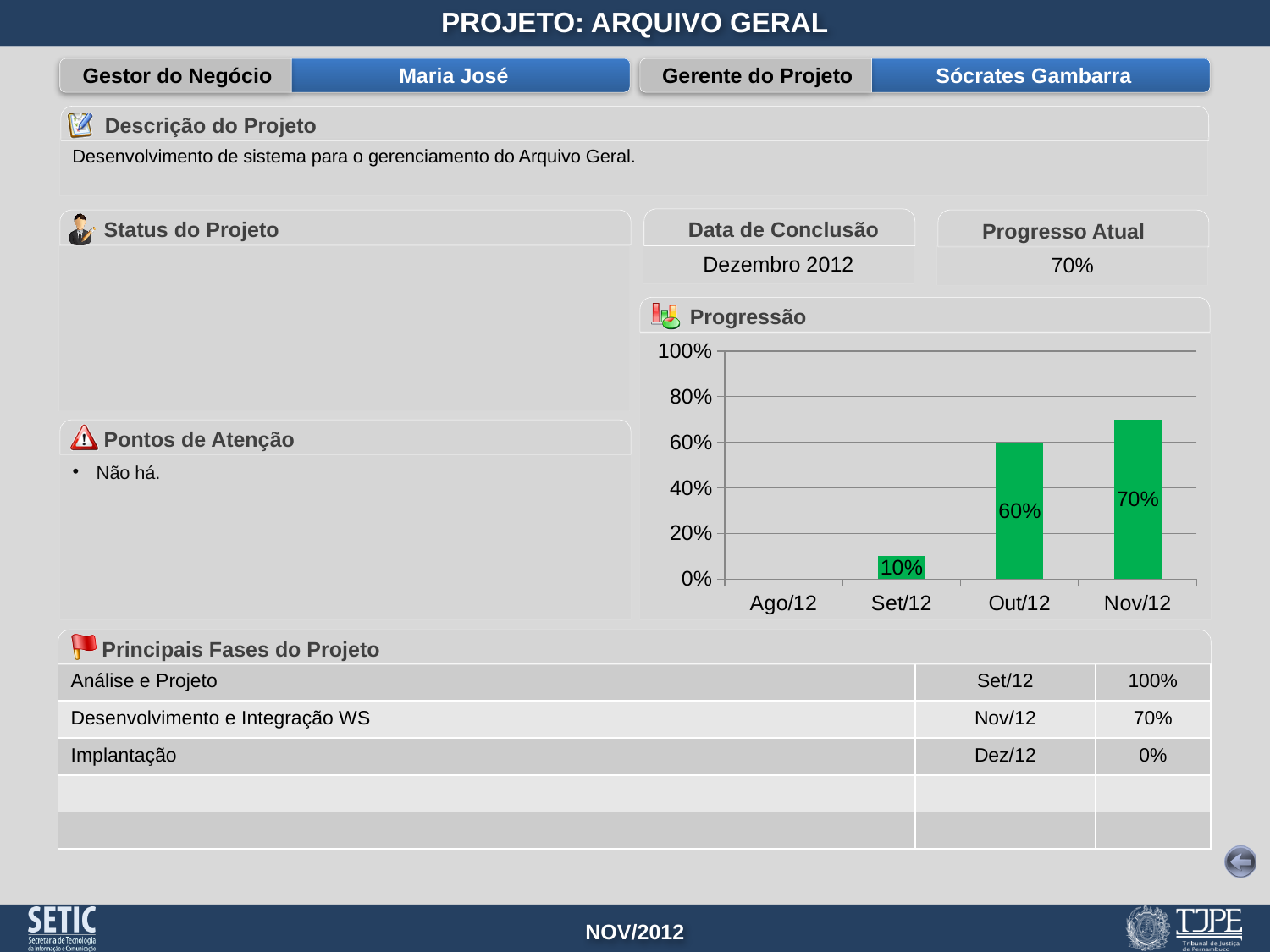
What is the value for Set/12 in the Progressão chart? 10% Which month has the highest value in the Progressão chart? Nov/12 Do the values in the Progressão chart rise or fall from Set/12 to Nov/12? rise Which month with a labelled bar has the lowest value in the Progressão chart? Set/12 Which is larger in the Progressão chart, the value for Set/12 or the value for Out/12? Out/12 What is the value for Nov/12 in the Progressão chart? 70% What is the value for Out/12 in the Progressão chart? 60% What kind of chart is the Progressão chart? bar chart Is the value for Nov/12 in the Progressão chart greater or less than 80%? less What is the difference between the values for Nov/12 and Out/12 in the Progressão chart? 10% What is the difference between the values for Out/12 and Set/12 in the Progressão chart? 50% How many months are shown on the x axis of the Progressão chart? 4